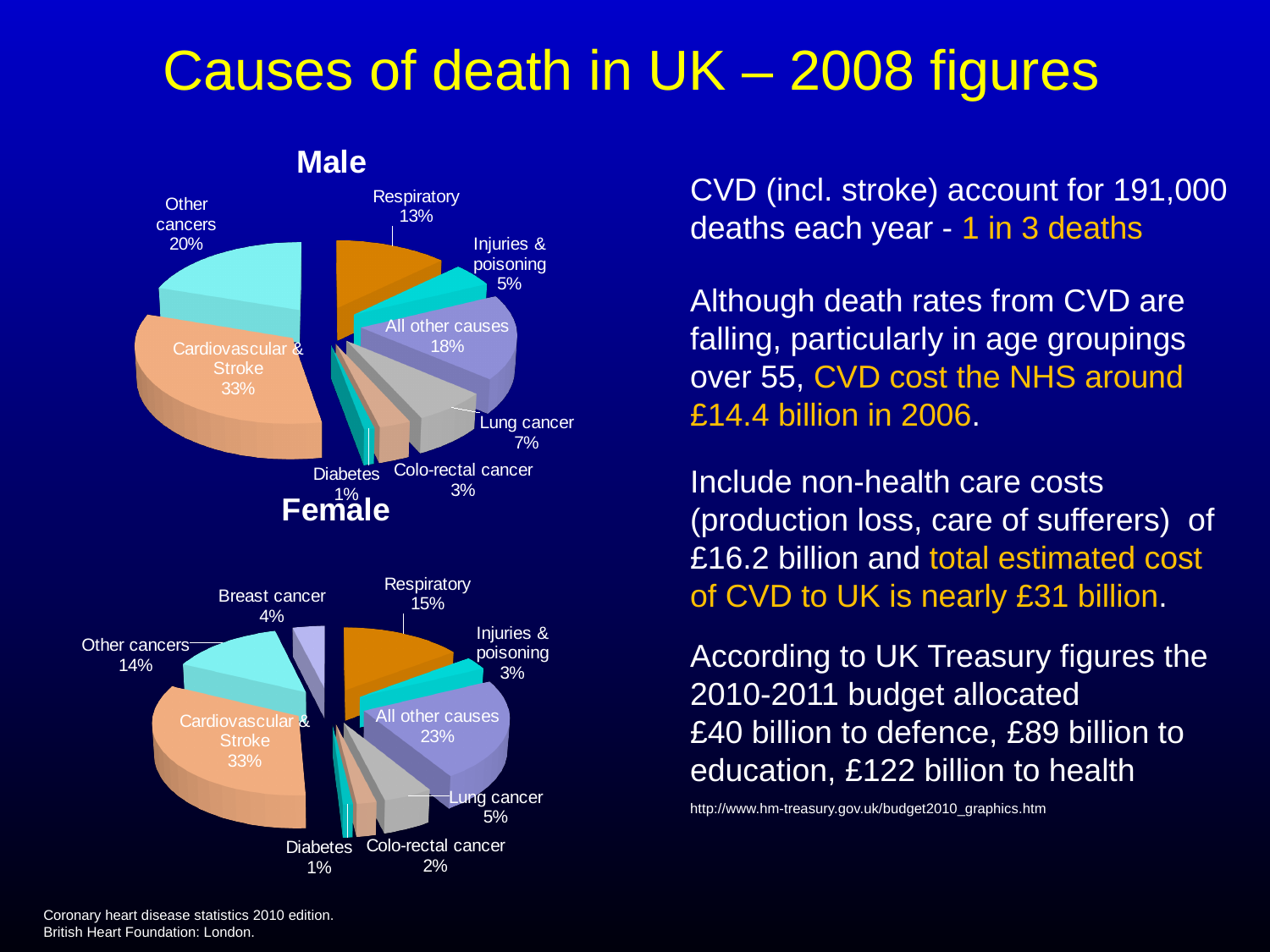
In the Female chart, what percentage of deaths is attributed to All other causes? 23% In the Female chart, which cause of death has the smallest share? Diabetes In the Female chart, what share of deaths is due to Breast cancer? 4% How many categories are shown in the Female chart? 9 In the Female chart, what is the difference in percentage points between Respiratory and Injuries & poisoning? 12 How many categories are shown in the Male chart? 8 What type of chart is used for the Male causes of death? Pie chart In the Male chart, what percentage of deaths is attributed to Cardiovascular & Stroke? 33% In the Male chart, which cause of death has the largest share? Cardiovascular & Stroke In the Male chart, which is larger: the share for Respiratory or the share for Lung cancer? Respiratory In the Male chart, what is the difference in percentage points between Other cancers and Lung cancer? 13 What is the title of the chart at the bottom left of the slide? Female